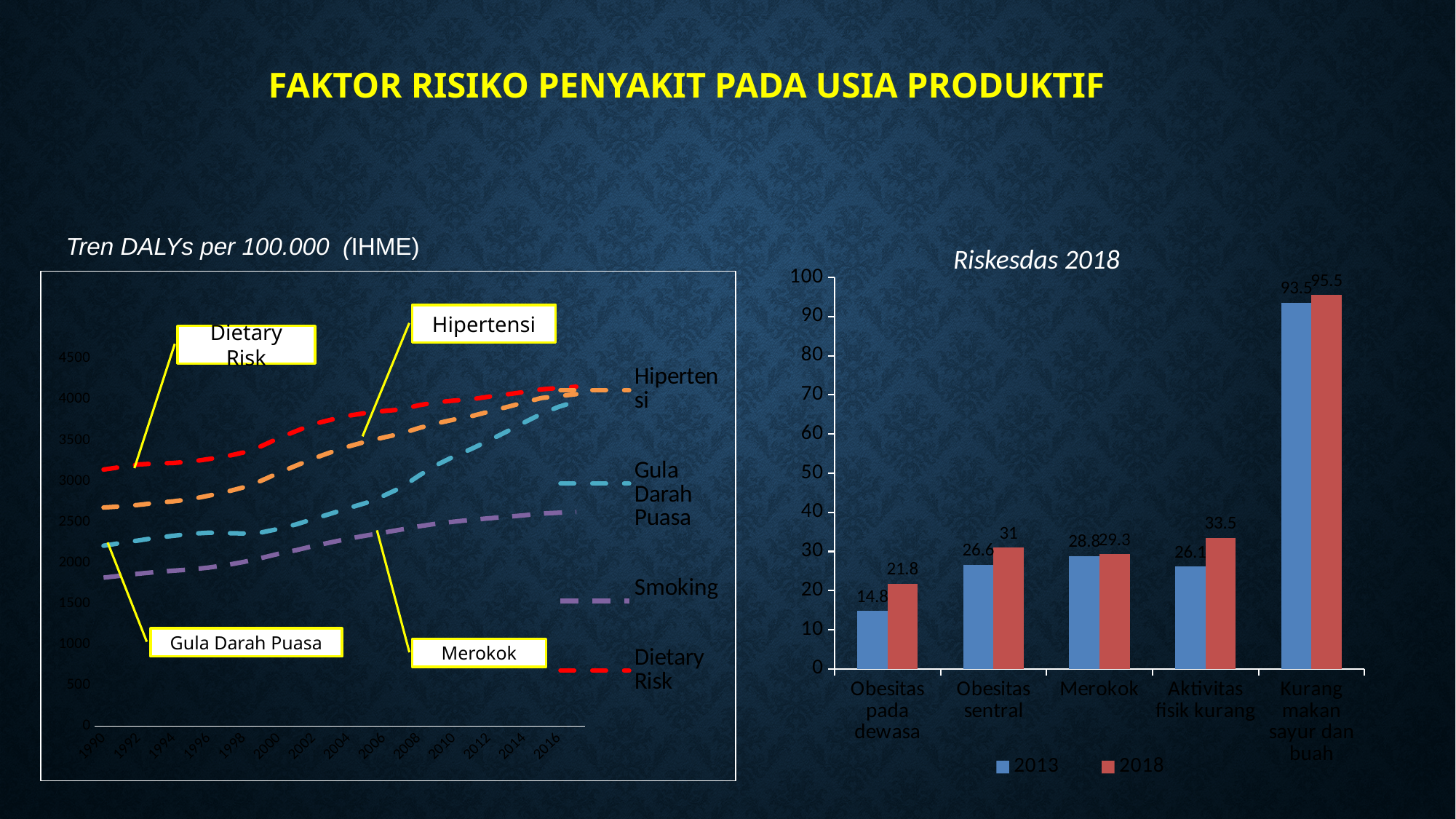
In the Riskesdas 2018 chart, which category has the highest 2018 value? Kurang makan sayur dan buah In the Tren DALYs per 100.000 (IHME) chart, does the Hipertensi line rise or fall from 1990 to 2016? Rise In the Riskesdas 2018 chart, what is the 2013 value for Obesitas pada dewasa? 14.8 In the Riskesdas 2018 chart, what is the 2018 value for Aktivitas fisik kurang? 33.5 In the Riskesdas 2018 chart, what is the difference between the 2018 and 2013 values for Kurang makan sayur dan buah? 2 In the Riskesdas 2018 chart, which is larger: the 2013 value for Obesitas sentral or the 2013 value for Merokok? Merokok In the Riskesdas 2018 chart, what is the difference between the 2018 and 2013 values for Aktivitas fisik kurang? 7.4 What kind of chart is the Tren DALYs per 100.000 (IHME) chart on the left? Line chart How many categories are shown on the x axis of the Riskesdas 2018 chart? 5 How many series does the legend of the Riskesdas 2018 chart list? 2 In the Riskesdas 2018 chart, which category has the lowest 2013 value? Obesitas pada dewasa In the Riskesdas 2018 chart, what is the 2018 value for Obesitas sentral? 31